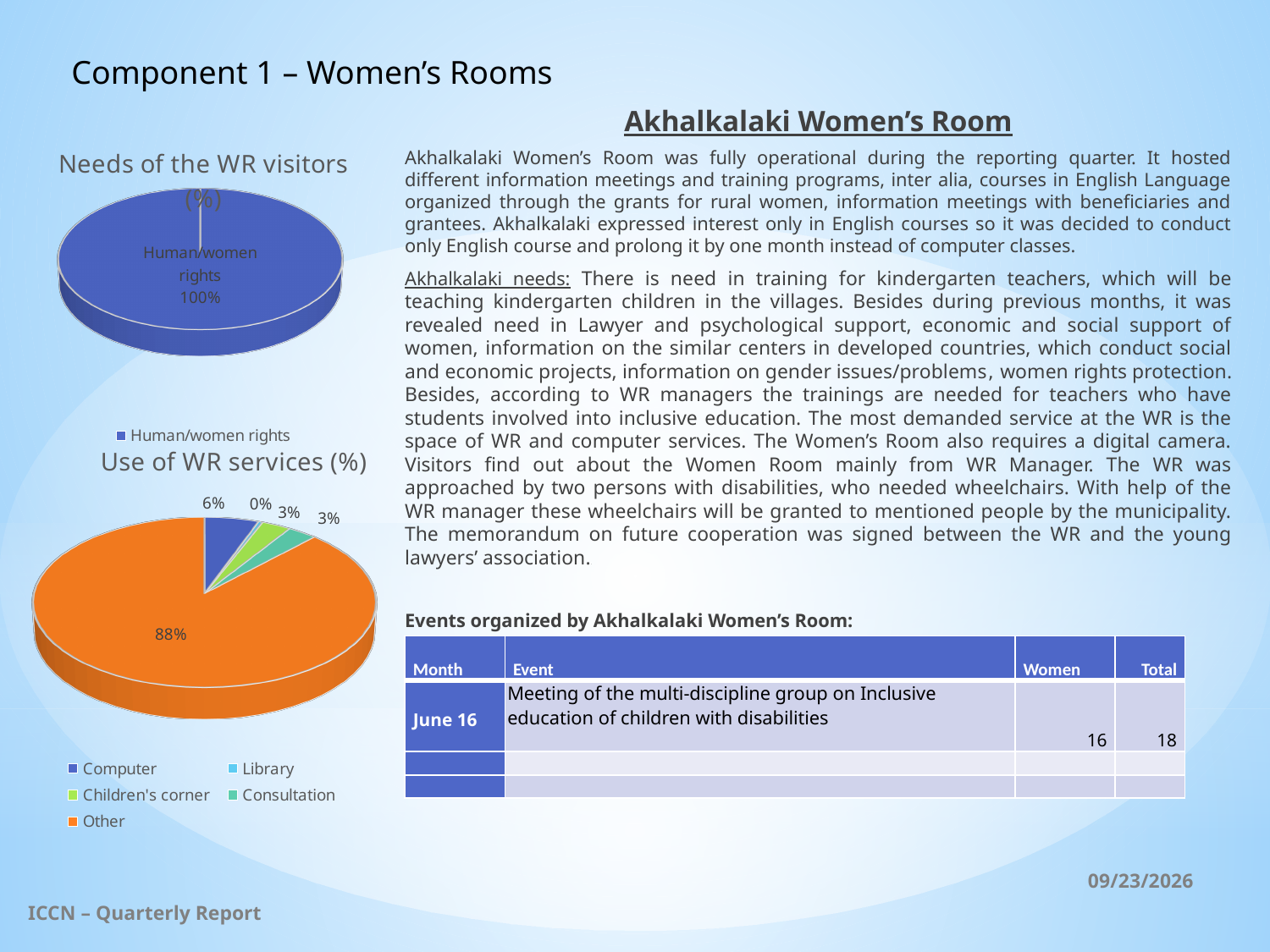
How many categories does the legend of the 'Use of WR services (%)' chart list? 5 What kind of chart is 'Use of WR services (%)'? Pie chart On the 'Use of WR services (%)' chart, what colour is the Other slice? Orange On the 'Use of WR services (%)' chart, what is the difference between the shares for Other and Computer? 82% On the 'Needs of the WR visitors (%)' chart, what share does Human/women rights have? 100% On the 'Use of WR services (%)' chart, which category has the largest share? Other How many categories does the legend of the 'Needs of the WR visitors (%)' chart list? 1 On the 'Use of WR services (%)' chart, what share does Library have? 0% On the 'Use of WR services (%)' chart, what share does Other have? 88% On the 'Use of WR services (%)' chart, which is larger, the share for Computer or the share for Consultation? Computer On the 'Use of WR services (%)' chart, what share does Computer have? 6% On the 'Use of WR services (%)' chart, which category has the smallest share? Library